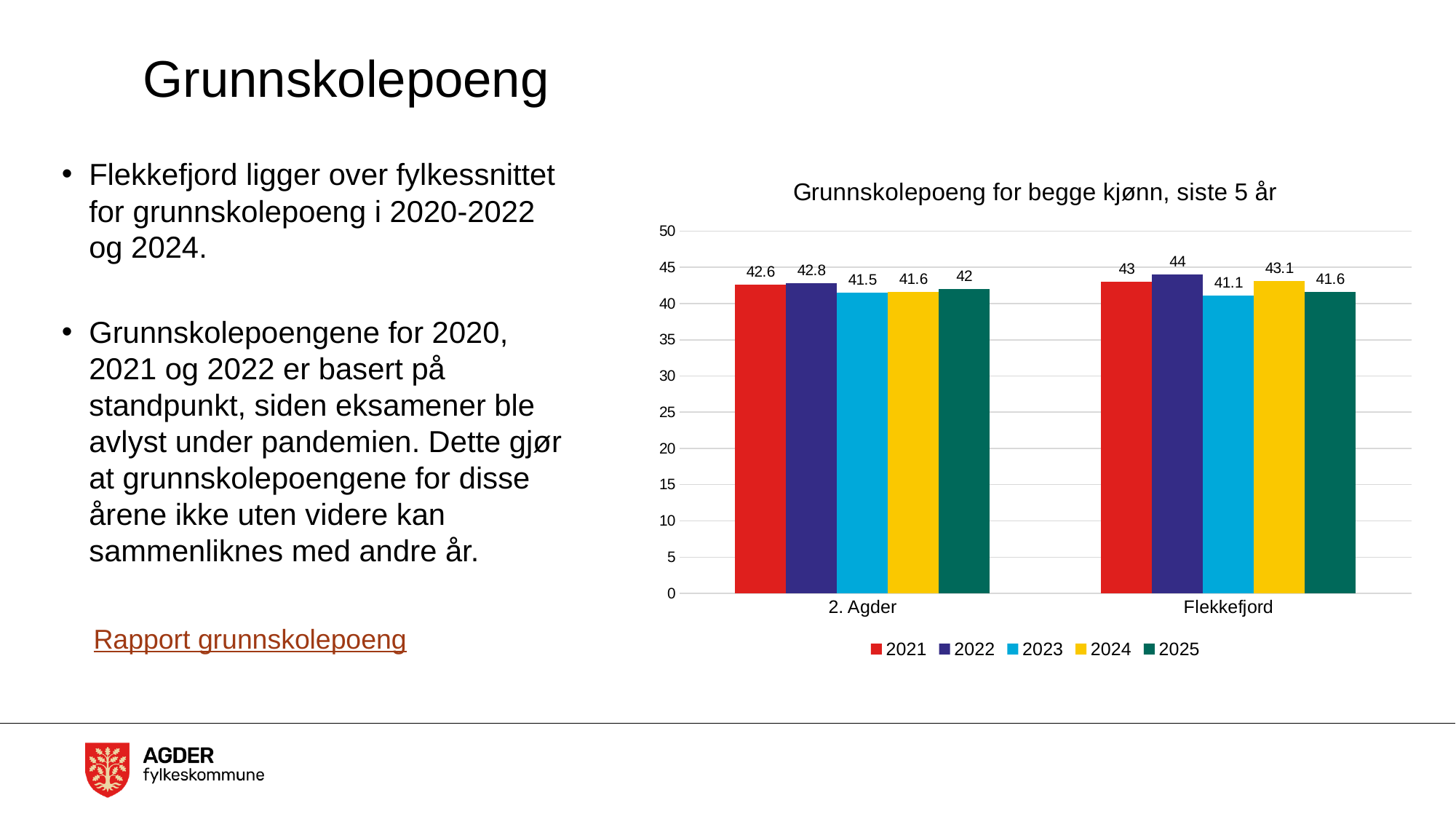
Which is larger, the 2021 value for 2. Agder or the 2021 value for Flekkefjord? Flekkefjord What is the value for Flekkefjord in 2025? 41.6 What is the difference between the 2022 and 2023 values for Flekkefjord? 2.9 Which year has the lowest value for Flekkefjord? 2023 How many series does the legend list? 5 What kind of chart is shown? Bar chart What is the value for Flekkefjord in 2022? 44 What is the value for 2. Agder in 2023? 41.5 What is the difference between Flekkefjord and 2. Agder in 2024? 1.5 What is the title of the chart? Grunnskolepoeng for begge kjønn, siste 5 år Which year has the highest value for Flekkefjord? 2022 Which year has the lowest value for 2. Agder? 2023